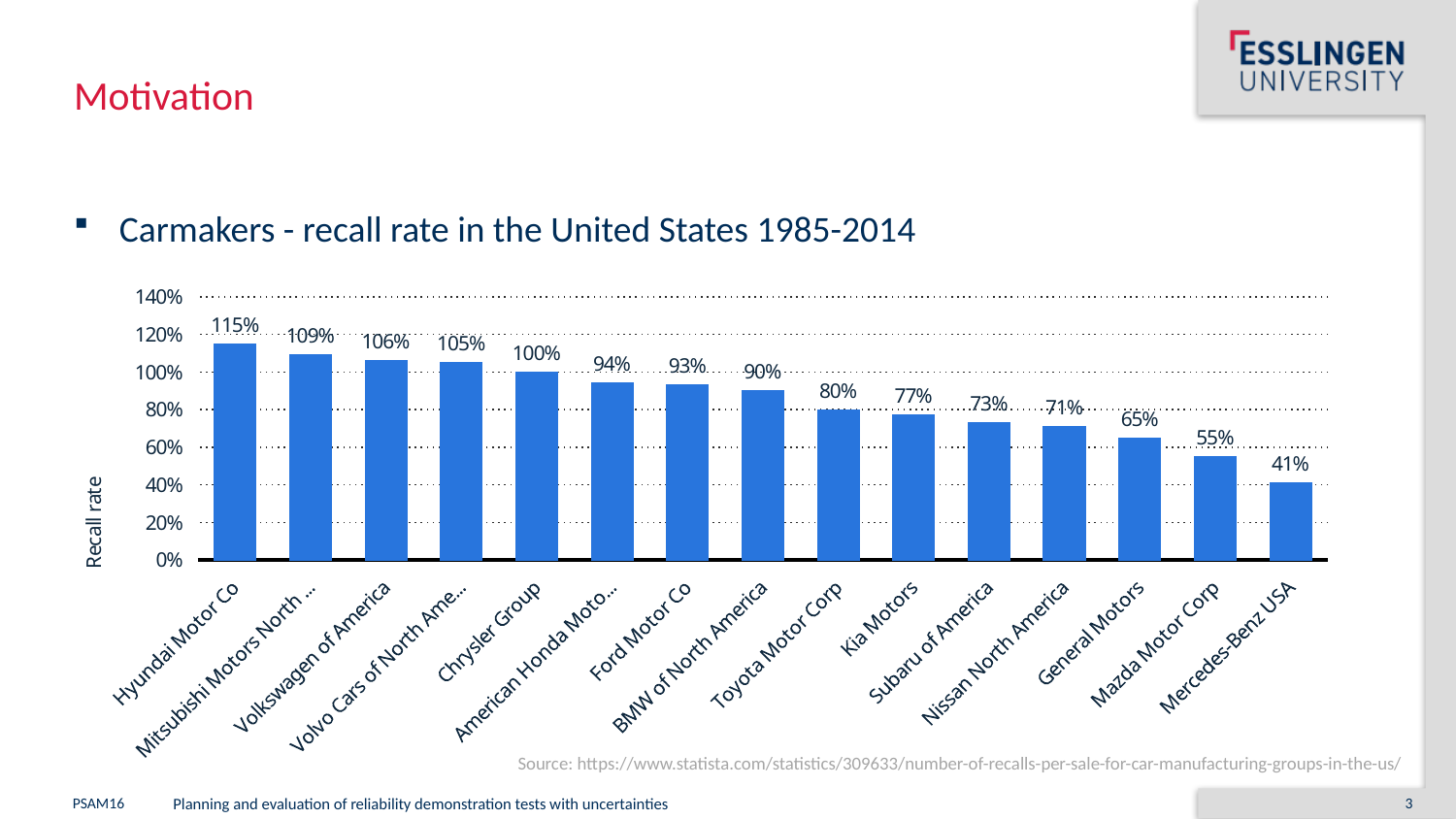
What is the recall rate for Ford Motor Co? 93% What is the recall rate for Hyundai Motor Co? 115% What is the difference in recall rate between Chrysler Group and Mazda Motor Corp? 45% Which carmaker has the lowest recall rate? Mercedes-Benz USA Do the recall rates rise or fall from left to right along the x axis? Fall Which carmaker has the highest recall rate? Hyundai Motor Co What is the recall rate for Kia Motors? 77% What is the recall rate for General Motors? 65% What is the label of the vertical axis? Recall rate Which has a higher recall rate, Toyota Motor Corp or Subaru of America? Toyota Motor Corp How many carmakers are shown in the chart? 15 What type of chart is shown on the slide? Bar chart